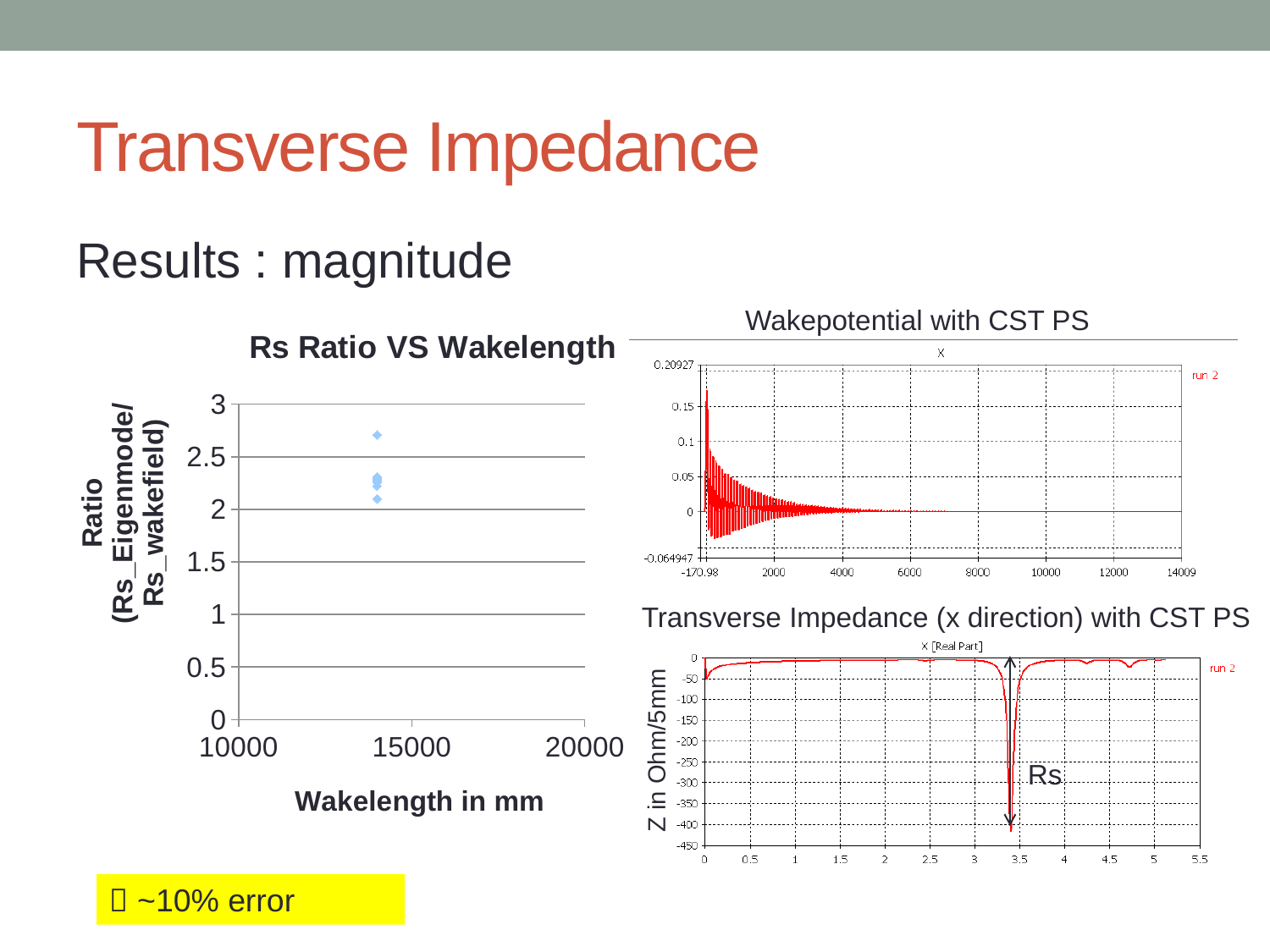
What is the maximum value shown on the y axis of the 'Rs Ratio VS Wakelength' chart? 3 In the 'Wakepotential with CST PS' chart, does the amplitude of the oscillation grow or decay as x increases? decay In the 'Rs Ratio VS Wakelength' chart, are the plotted ratio values greater or less than 3? less What kind of chart is the 'Rs Ratio VS Wakelength' chart? scatter chart In the 'Wakepotential with CST PS' chart, what series name does the legend show? run 2 What is the x-axis title of the 'Rs Ratio VS Wakelength' chart? Wakelength in mm In the 'Transverse Impedance (x direction) with CST PS' chart, is the deepest dip located at an x value greater or less than 3? greater In the 'Rs Ratio VS Wakelength' chart, are the plotted ratio values greater or less than 2? greater In the 'Wakepotential with CST PS' chart, what is the maximum value labelled on the y axis? 0.20927 In the 'Transverse Impedance (x direction) with CST PS' chart, what is the y-axis title? Z in Ohm/5mm